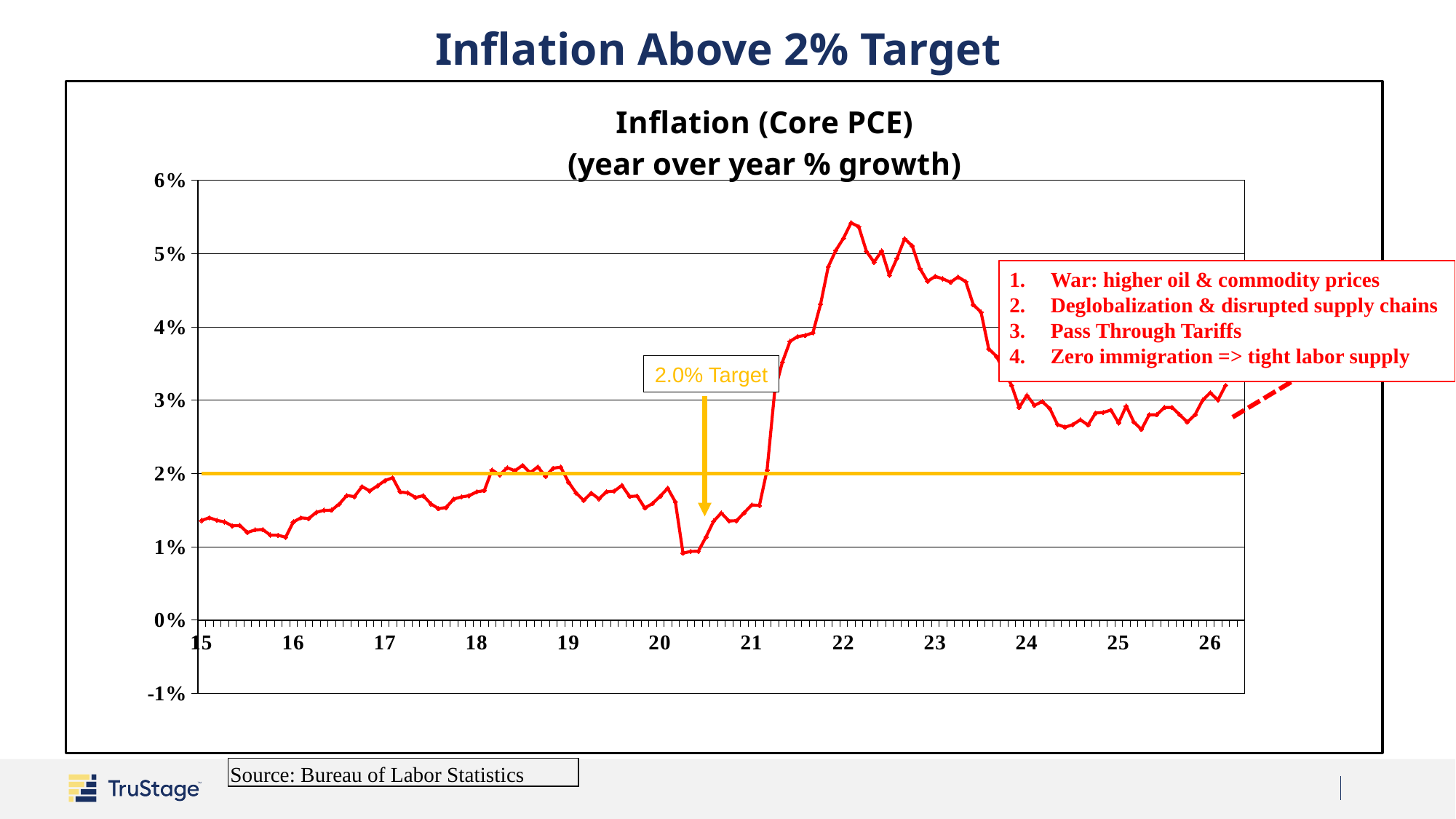
In which year does Core PCE inflation reach its highest value on the chart? 22 What is the title of the chart? Inflation (Core PCE) (year over year % growth) Does Core PCE inflation rise or fall between 2022 and 2024? fall Is the value of Core PCE inflation during 2025 greater or less than 4%? less What target level is marked by the horizontal yellow line on the chart? 2.0% Target Does Core PCE inflation rise or fall between the start of 2021 and the start of 2022? rise Is the value of Core PCE inflation at the start of 2015 greater or less than 2%? less Is the value of Core PCE inflation in mid-2020 greater or less than 2%? less What kind of chart is shown on the slide? line chart In which year does Core PCE inflation reach its lowest value on the chart? 20